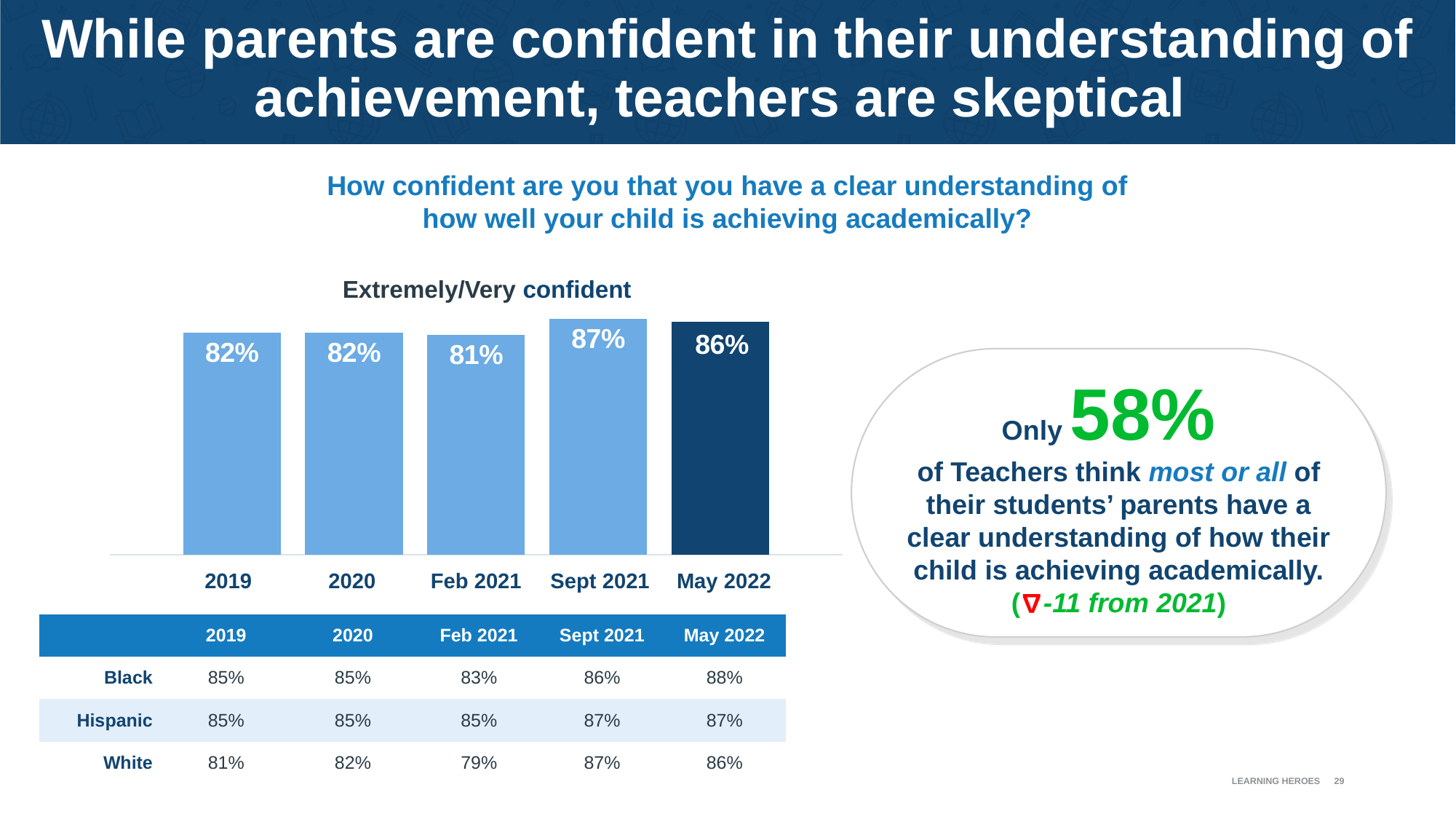
What is the difference between the 2020 and Feb 2021 values in the bar chart? 1 percentage point What value is shown for Feb 2021 in the bar chart? 81% How many bars are shown in the chart? 5 What type of chart is used to show the 'Extremely/Very confident' data? Bar chart Which is larger in the bar chart, the value for 2019 or the value for Sept 2021? Sept 2021 Which bar in the chart is shown in a darker blue colour than the others? May 2022 Did the value rise or fall from Sept 2021 to May 2022 in the bar chart? Fall What is the difference between the Sept 2021 and Feb 2021 values in the bar chart? 6 percentage points Which period has the highest bar in the chart? Sept 2021 Which period has the lowest bar in the chart? Feb 2021 What percentage of parents were extremely/very confident in May 2022? 86% What is the title of the bar chart? Extremely/Very confident